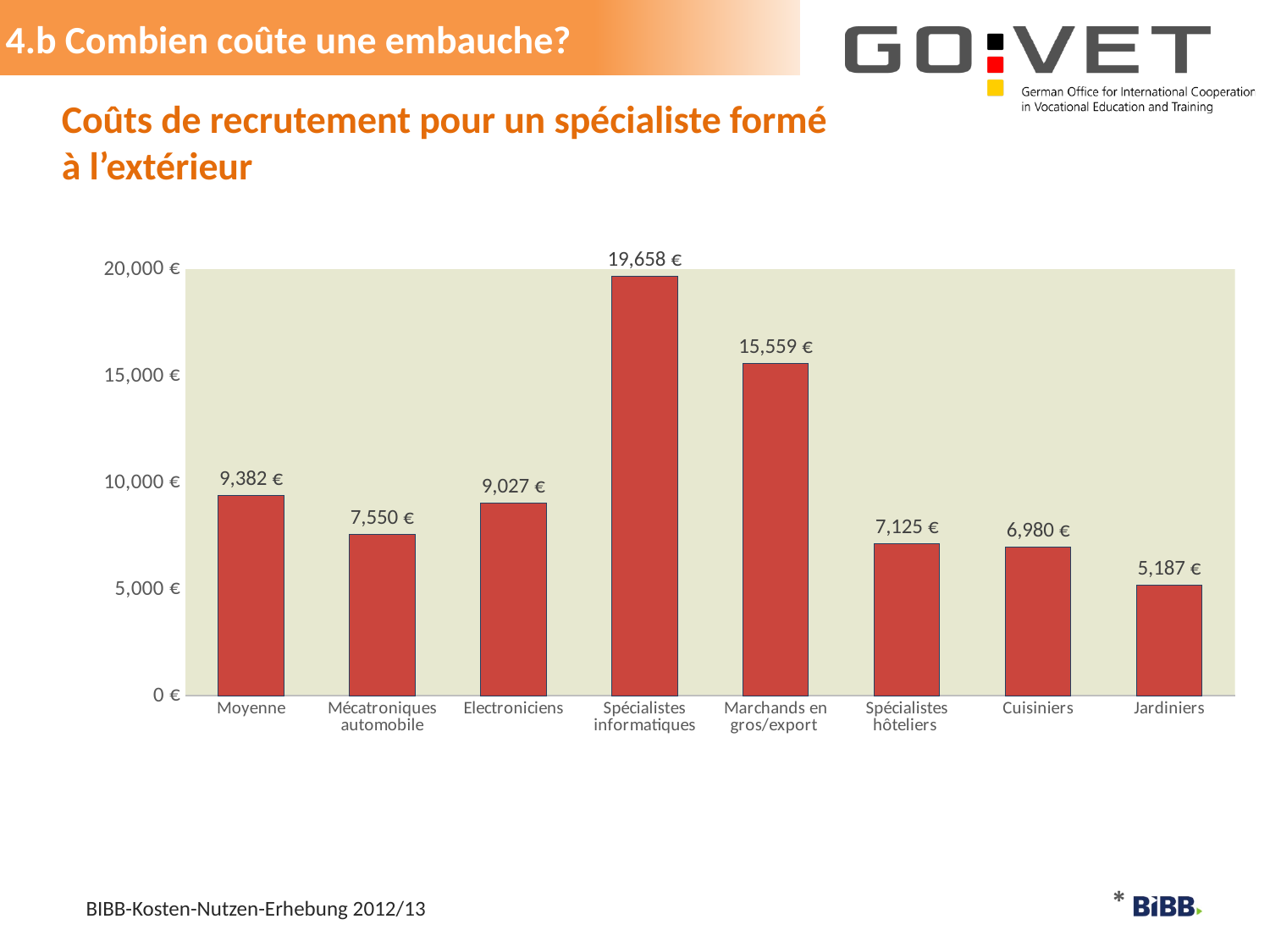
What is the recruitment cost for Jardiniers? 5,187 € What is the difference between the values for Spécialistes informatiques and Marchands en gros/export? 4,099 € Is the value for Marchands en gros/export greater or less than 15,000 €? greater What is the difference between the values for Spécialistes hôteliers and Cuisiniers? 145 € What kind of chart is shown on the slide? bar chart How many categories are shown on the x axis? 8 Which category has the lowest recruitment cost? Jardiniers What is the value shown for Moyenne? 9,382 € Which is larger, the value for Mécatroniques automobile or the value for Electroniciens? Electroniciens What colour are the bars in the chart? red Which category has the highest recruitment cost? Spécialistes informatiques What is the recruitment cost for Spécialistes informatiques? 19,658 €